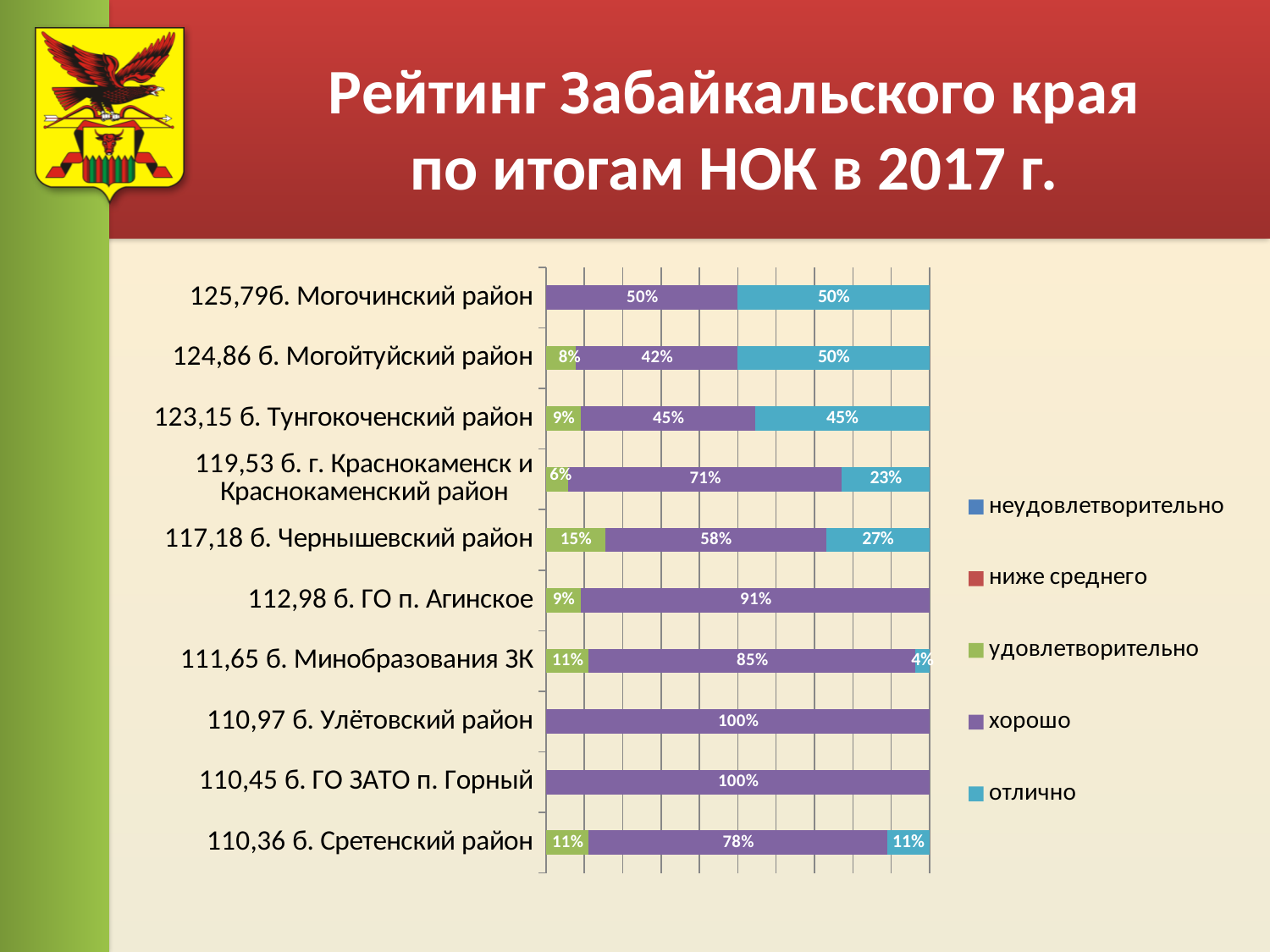
How many categories (districts/organisations) are plotted on the chart? 10 Which category has the highest "удовлетворительно" share? 117,18 б. Чернышевский район What is the "отлично" share for "110,36 б. Сретенский район"? 11% What is the "удовлетворительно" share for "111,65 б. Минобразования ЗК"? 11% What is the "хорошо" share for "119,53 б. г. Краснокаменск и Краснокаменский район"? 71% What colour represents the "отлично" series in the legend? Blue (teal) What kind of chart is shown on the slide? Stacked bar chart Which category has the lowest "хорошо" share? 124,86 б. Могойтуйский район How many series does the legend list? 5 For "117,18 б. Чернышевский район", what is the difference between the "хорошо" share and the "отлично" share? 31 percentage points What is the "отлично" share for "117,18 б. Чернышевский район"? 27% Which has the larger "хорошо" share: "123,15 б. Тунгокоченский район" or "119,53 б. г. Краснокаменск и Краснокаменский район"? 119,53 б. г. Краснокаменск и Краснокаменский район